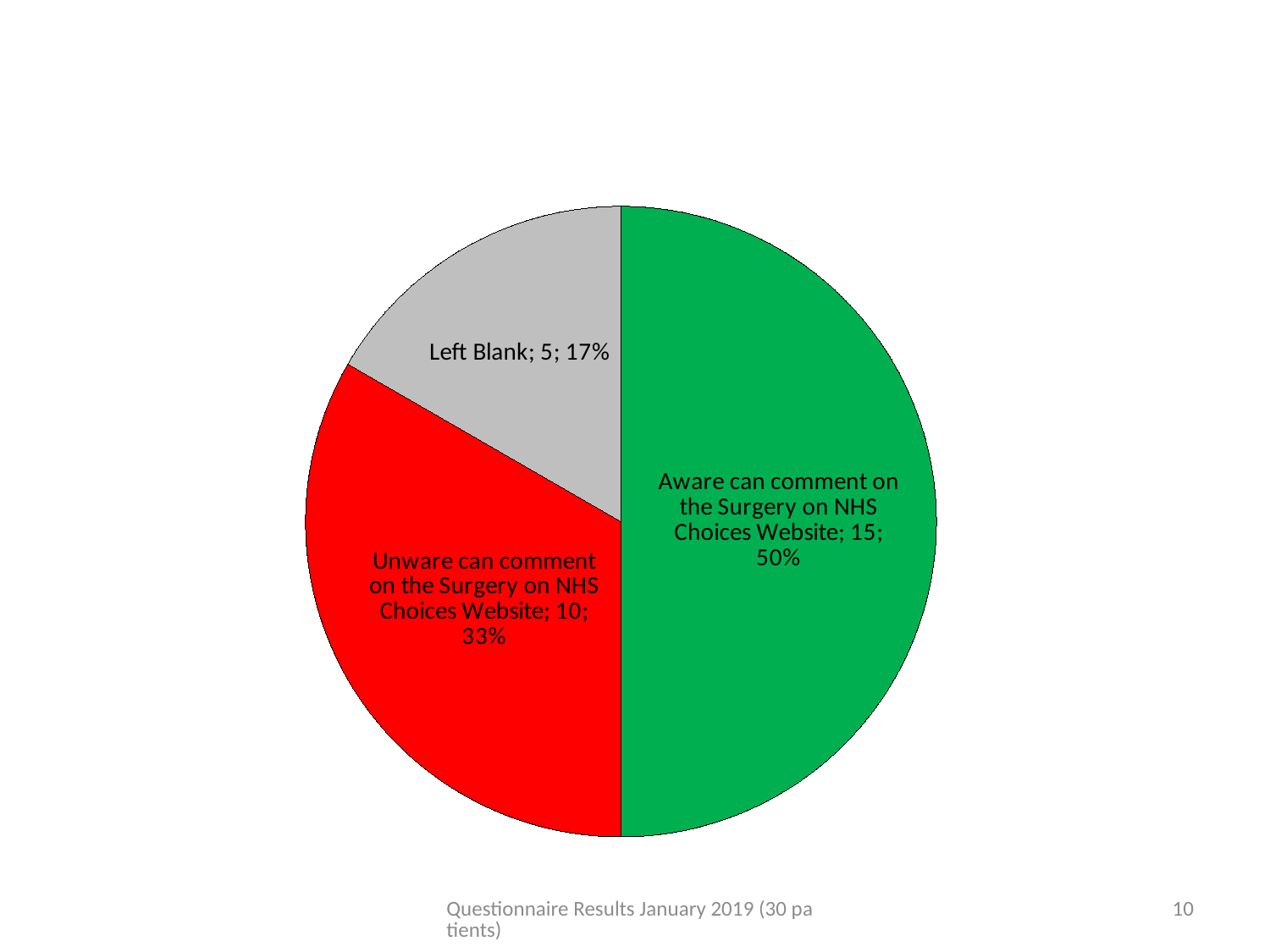
What kind of chart is shown on the slide? pie chart How many responses were left blank? 5 What colour is the 'Left Blank' slice? grey What share of the pie is the 'Aware can comment on the Surgery on NHS Choices Website' slice? 50% Which is larger: the 'Unware can comment' slice or the 'Left Blank' slice? Unware can comment on the Surgery on NHS Choices Website How many slices does the pie chart have? 3 How many patients were unaware they can comment on the Surgery on the NHS Choices Website? 10 Which slice is the largest? Aware can comment on the Surgery on NHS Choices Website Which slice is the smallest? Left Blank What percentage of the pie is the 'Left Blank' slice? 17% What is the difference between the number of patients aware and the number unaware they can comment on the Surgery on the NHS Choices Website? 5 How many patients were aware they can comment on the Surgery on the NHS Choices Website? 15